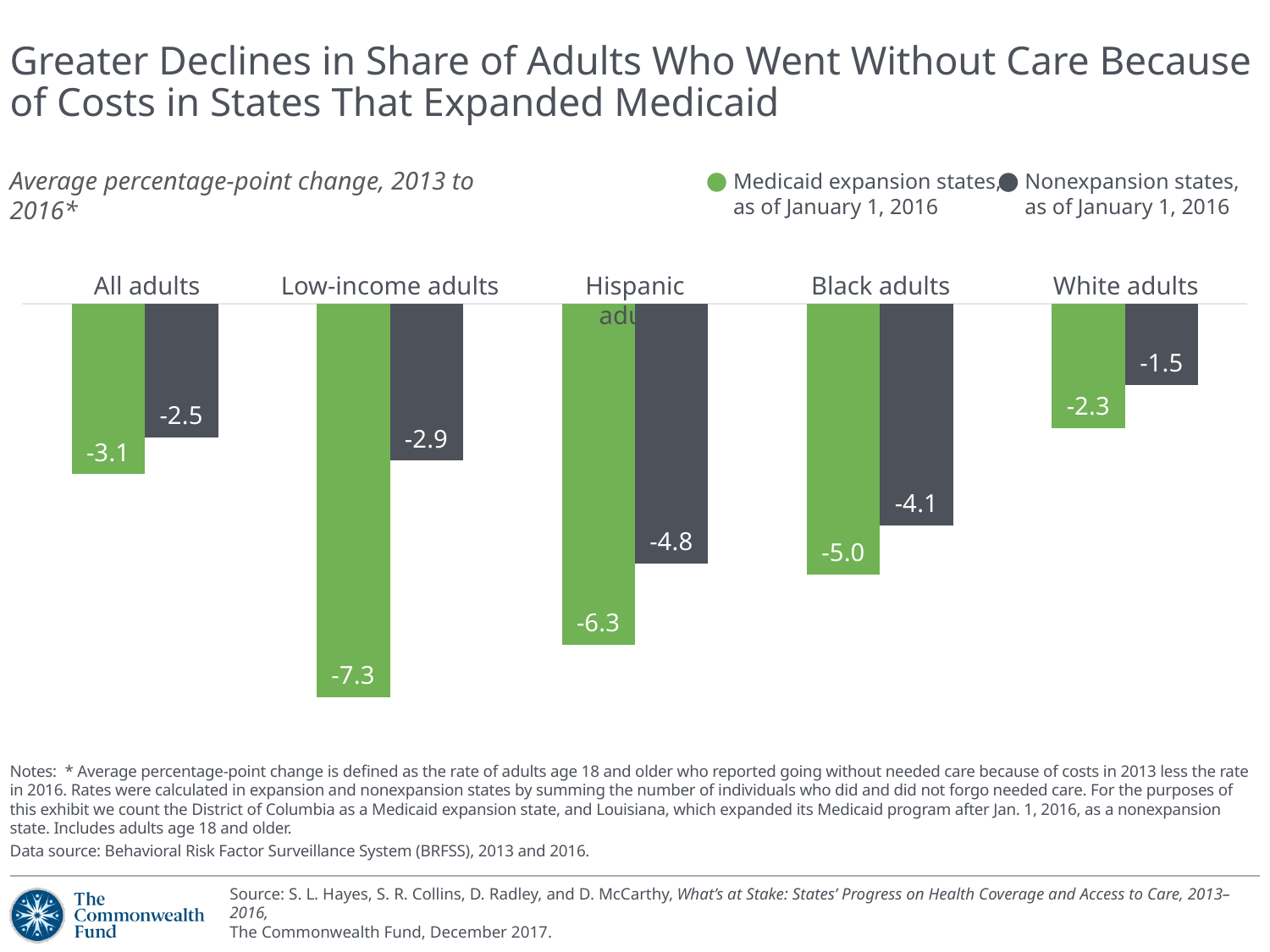
How many categories are shown on the chart? 5 What is the value for Medicaid expansion states for White adults? -2.3 What is the value for Medicaid expansion states for Low-income adults? -7.3 Which group has the larger decline for Nonexpansion states: Hispanic adults or Black adults? Hispanic adults How many series does the legend list? 2 What is the value for Nonexpansion states for Black adults? -4.1 Which category shows the largest decline for Medicaid expansion states? Low-income adults What is the value for Nonexpansion states for All adults? -2.5 Which colour represents Medicaid expansion states in the legend? Green What is the difference between the Medicaid expansion states value and the Nonexpansion states value for Hispanic adults? 1.5 What kind of chart is shown on the slide? Bar chart Which category shows the smallest decline for Nonexpansion states? White adults